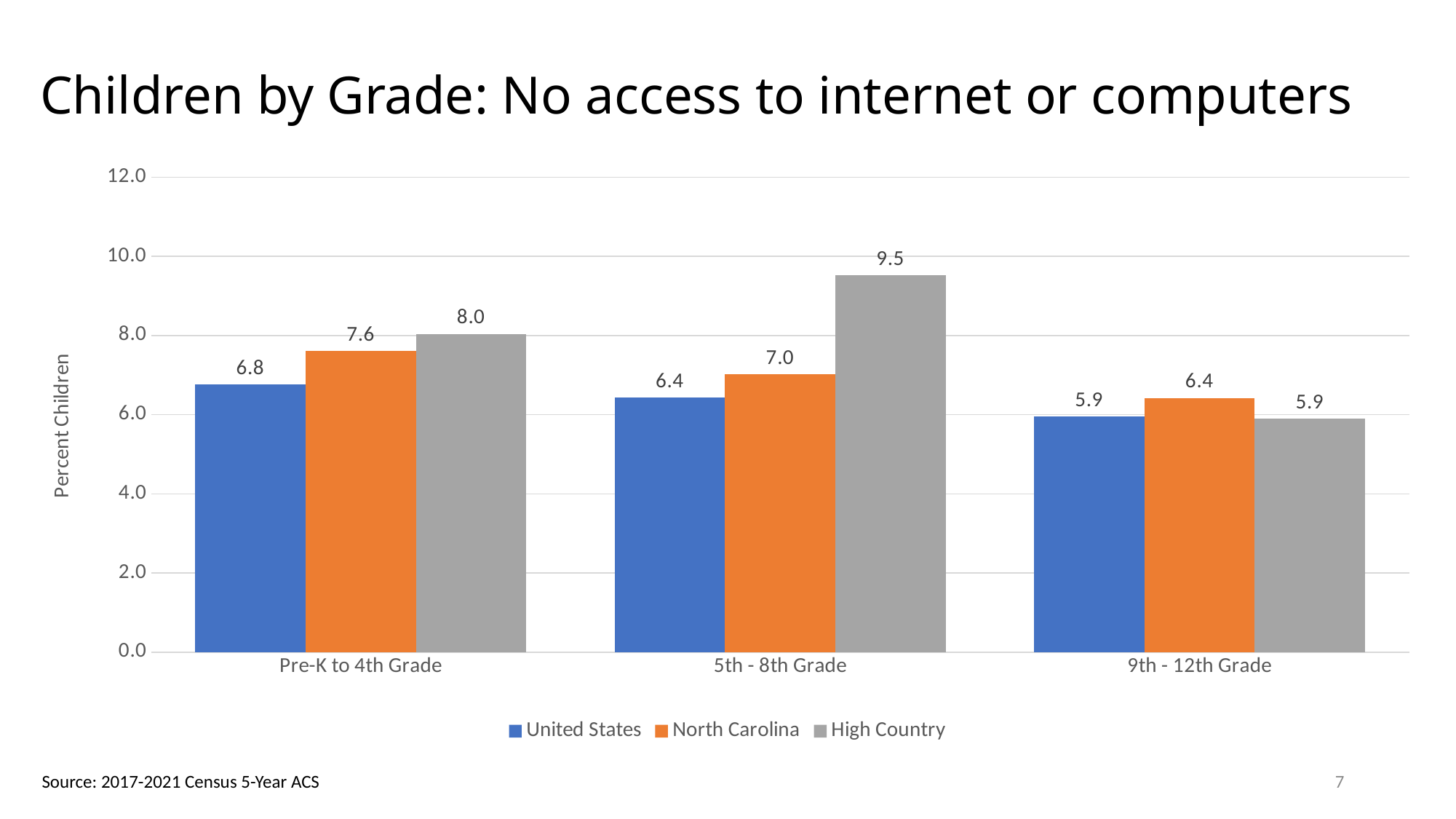
Which is larger in the Pre-K to 4th Grade category: North Carolina or United States? North Carolina What is the value for High Country in the 5th - 8th Grade category? 9.5 What is the value for North Carolina in the 9th - 12th Grade category? 6.4 How many series does the legend list? 3 What is the value for United States in the Pre-K to 4th Grade category? 6.8 What is the difference between the High Country and United States values in the 5th - 8th Grade category? 3.1 How many grade categories are shown on the x axis? 3 What kind of chart is shown on the slide? Bar chart Is the value for High Country in the 5th - 8th Grade category greater or less than 8.0? greater Which grade category has the lowest value for United States? 9th - 12th Grade Do the United States values rise or fall from Pre-K to 4th Grade to 9th - 12th Grade? Fall Which series has the highest value in the Pre-K to 4th Grade category? High Country